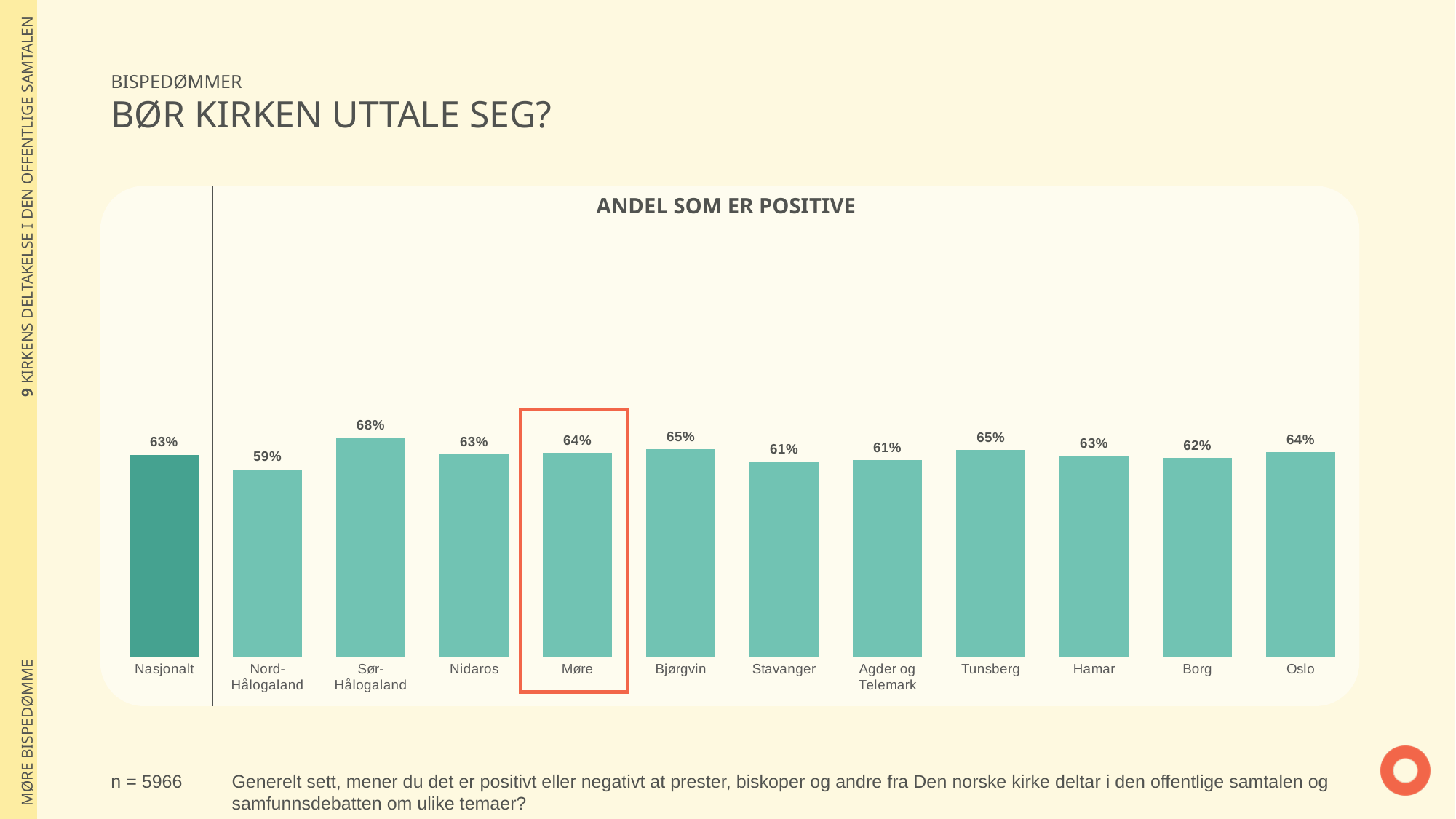
What is the value for Nasjonalt? 63% Which category has the highest value? Sør-Hålogaland Which is larger, the value for Tunsberg or the value for Stavanger? Tunsberg What is the title of the chart? ANDEL SOM ER POSITIVE What is the difference between the values for Sør-Hålogaland and Nord-Hålogaland? 9% What is the value for Møre? 64% Which category has the lowest value? Nord-Hålogaland What kind of chart is shown on the slide? Bar chart What is the value for Agder og Telemark? 61% What is the value for Nord-Hålogaland? 59% What is the difference between the values for Bjørgvin and Borg? 3% How many categories are shown in the chart? 12